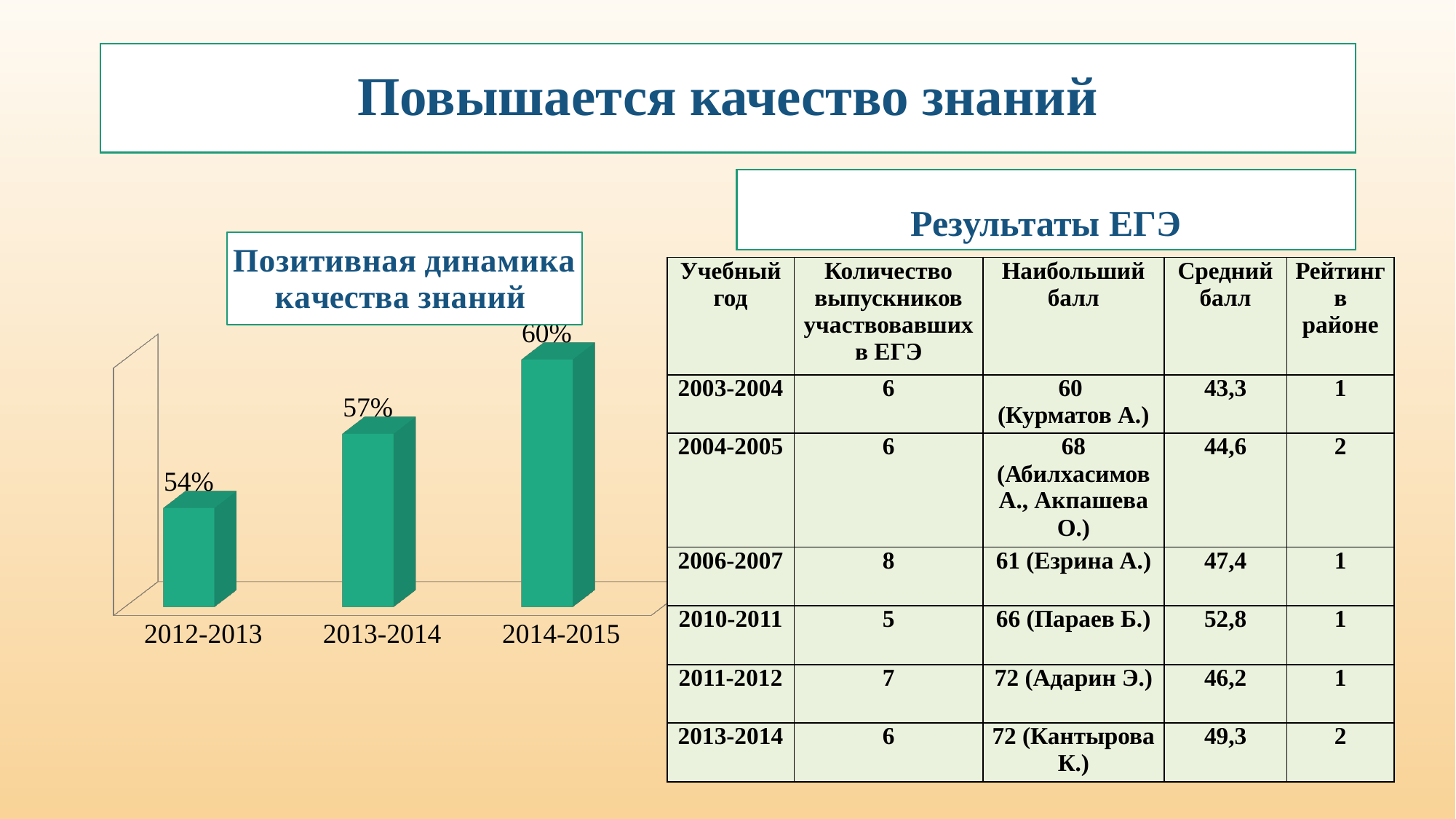
Which category has the highest value in the chart? 2014-2015 What is the value for 2012-2013 in the chart? 54% What is the difference between the values for 2014-2015 and 2012-2013? 6% Which category has the lowest value in the chart? 2012-2013 What kind of chart is shown on the slide? bar chart What is the title of the chart? Позитивная динамика качества знаний What is the value for 2014-2015 in the chart? 60% Which is larger, the value for 2013-2014 or the value for 2014-2015? 2014-2015 What is the value for 2013-2014 in the chart? 57% How many categories are shown in the chart? 3 What is the difference between the values for 2013-2014 and 2012-2013? 3% Do the values rise or fall from 2012-2013 to 2014-2015? rise